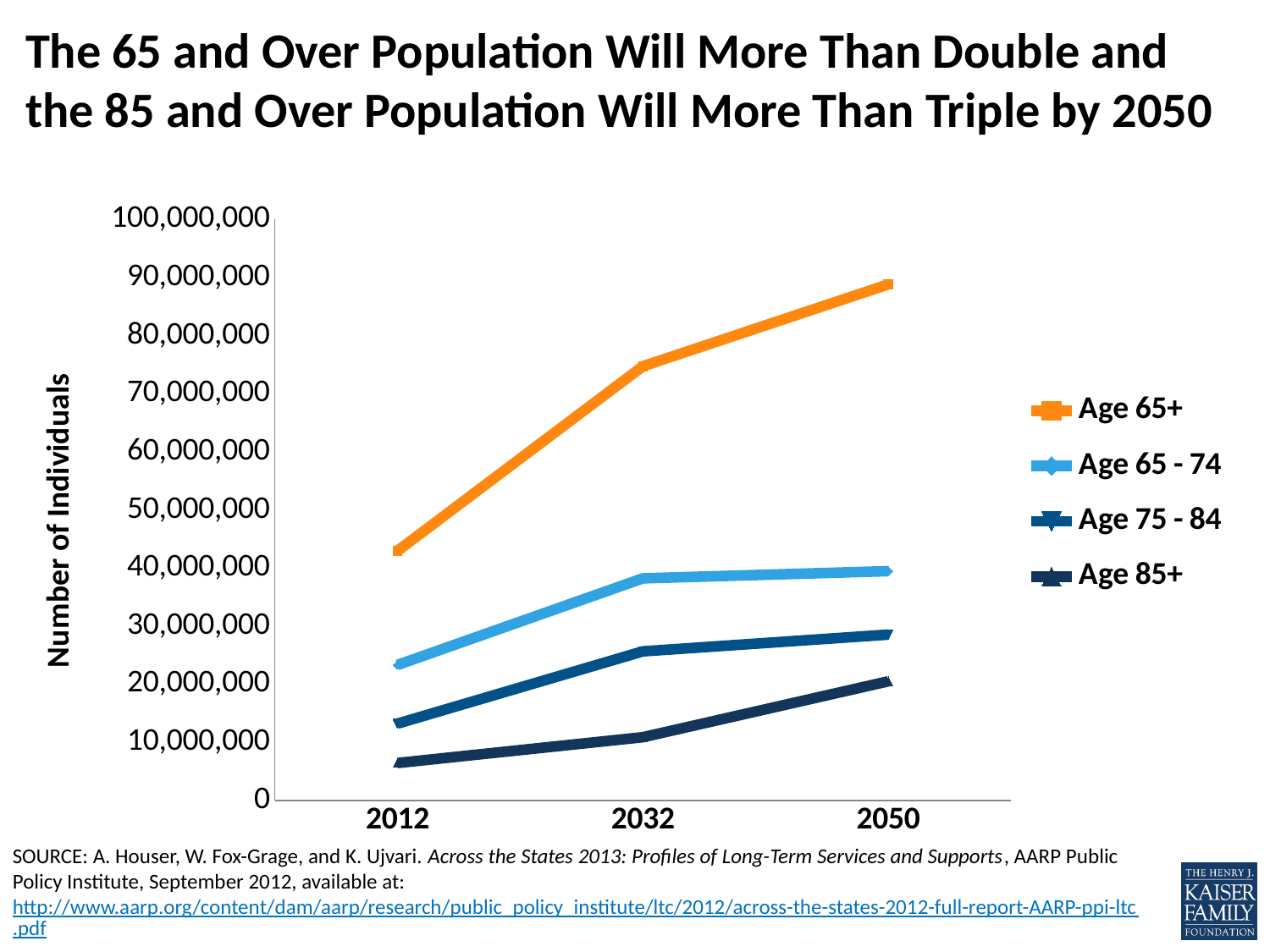
Is the value for Age 65+ in 2050 greater or less than 80,000,000? greater Is the value for Age 85+ in 2050 greater or less than 10,000,000? greater Is the value for Age 75 - 84 in 2032 greater or less than 20,000,000? greater What kind of chart is shown on the slide? line chart Does the Age 65+ line rise or fall from 2012 to 2050? rise How many series does the legend list? 4 How many years are shown on the x axis? 3 Which series has the highest value in 2050? Age 65+ Which series has the lowest value in 2012? Age 85+ Which is larger in 2012, the value for Age 65 - 74 or the value for Age 75 - 84? Age 65 - 74